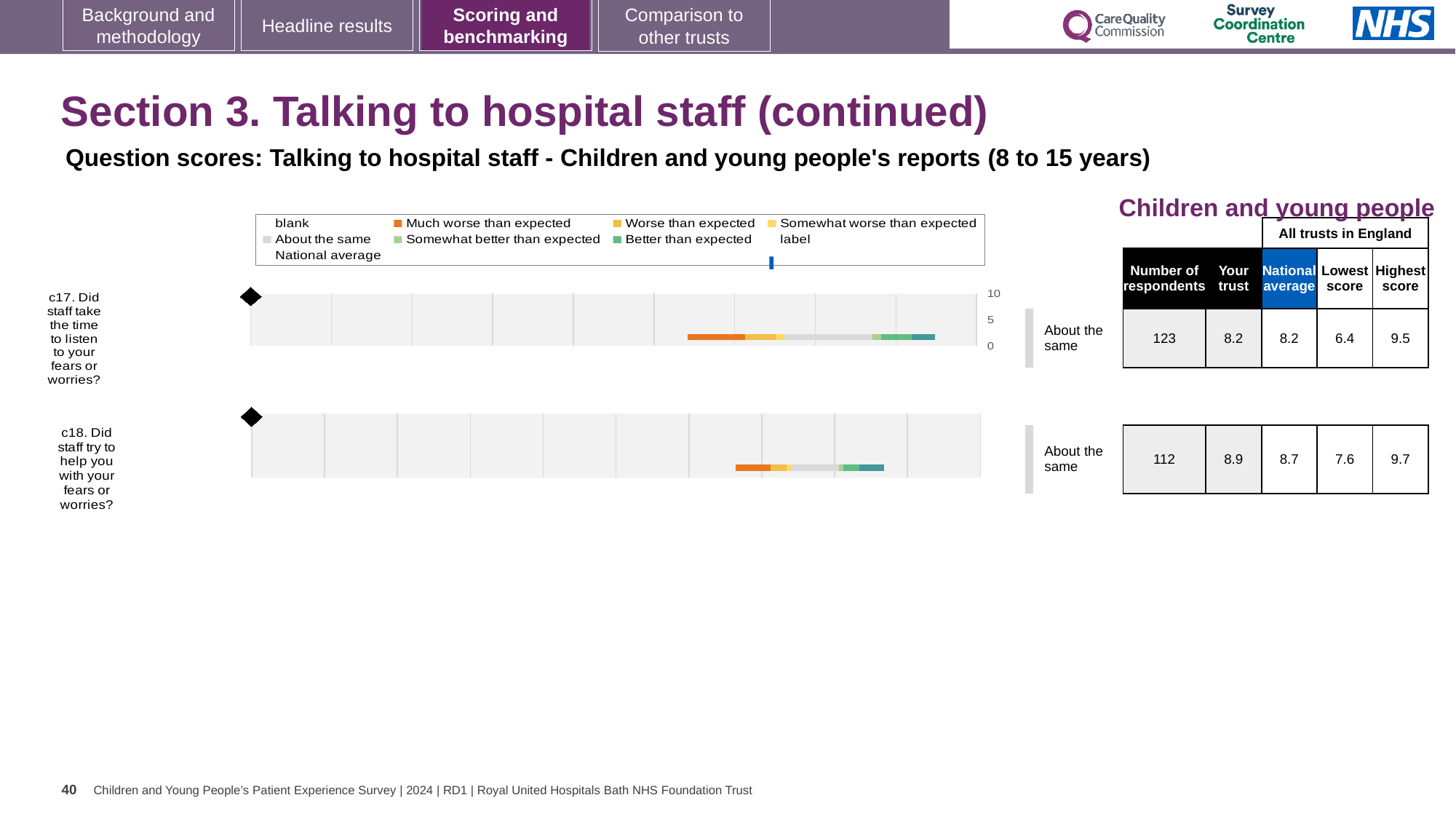
What is the 'Your trust' score for c18 (Did staff try to help you with your fears or worries?)? 8.9 How many respondents answered question c17? 123 How many survey questions are plotted on the slide? 2 What is the national average score for c18? 8.7 What is the difference between the highest and lowest scores for c17? 3.1 Which question has the higher 'Your trust' score, c17 or c18? c18 What is the highest score among all trusts in England for c18? 9.7 What benchmark category is shown for c17? About the same What kind of chart is used to show the benchmarking for questions c17 and c18? bar chart By how much does the trust's score for c18 exceed the national average for c18? 0.2 What is the 'Your trust' score for c17 (Did staff take the time to listen to your fears or worries?)? 8.2 What is the lowest score among all trusts in England for c17? 6.4